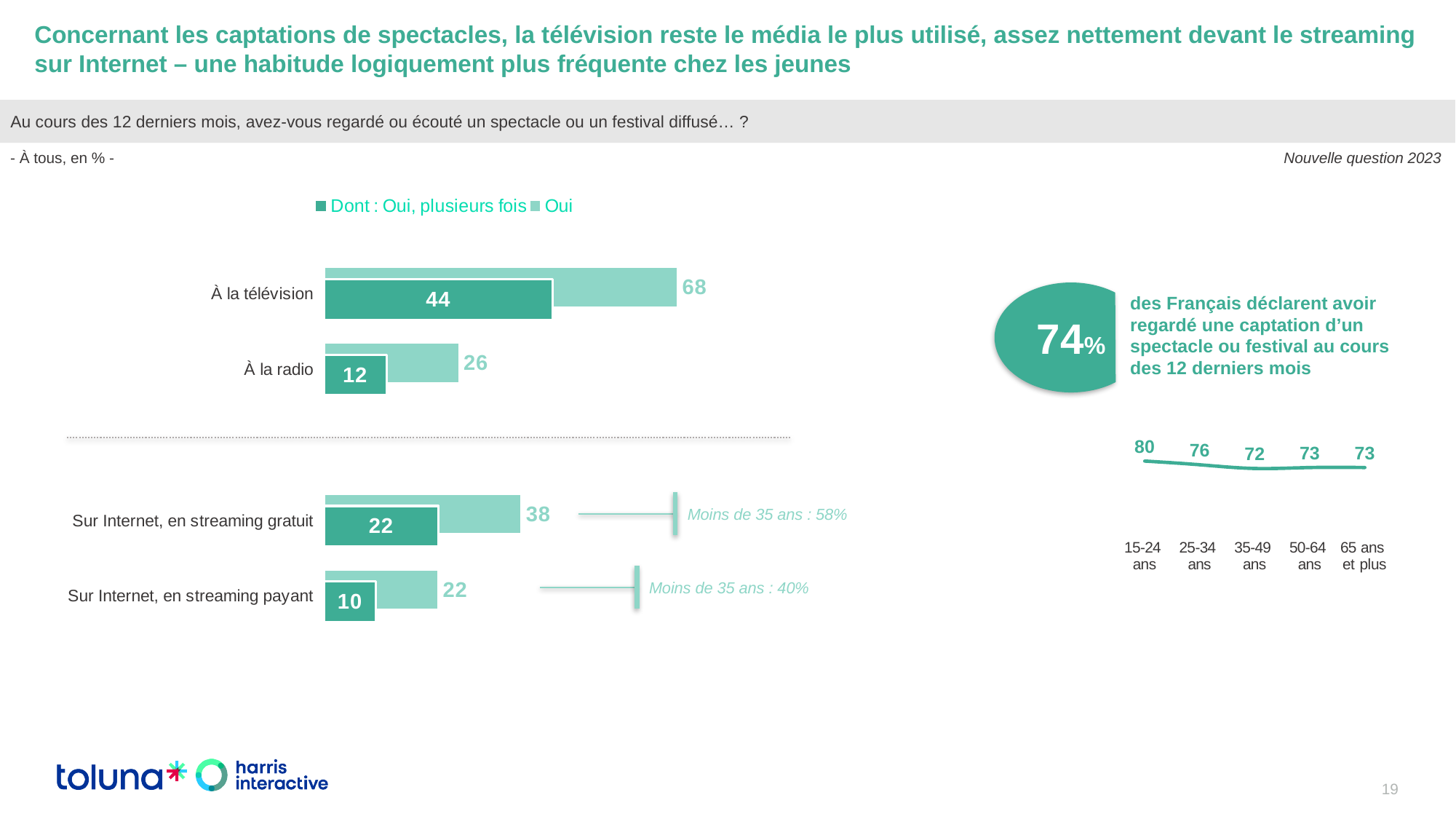
In the bar chart on the left, what is the 'Oui' value for 'Sur Internet, en streaming gratuit'? 38 In the line chart on the right, which age group has the lowest value? 35-49 ans In the bar chart on the left, what is the 'Dont : Oui, plusieurs fois' value for 'À la radio'? 12 In the bar chart on the left, which category has the lowest 'Dont : Oui, plusieurs fois' value? Sur Internet, en streaming payant What kind of chart is the chart on the left? Bar chart How many categories does the bar chart on the left show? 4 How many series does the legend of the bar chart on the left list? 2 In the bar chart on the left, which category has the highest 'Oui' value? À la télévision In the line chart on the right, what is the value for '15-24 ans'? 80 In the bar chart on the left, what is the difference between the 'Oui' values for 'À la télévision' and 'Sur Internet, en streaming gratuit'? 30 In the bar chart on the left, which is larger: the 'Oui' value for 'À la radio' or for 'Sur Internet, en streaming payant'? À la radio In the bar chart on the left, what is the 'Oui' value for 'À la télévision'? 68